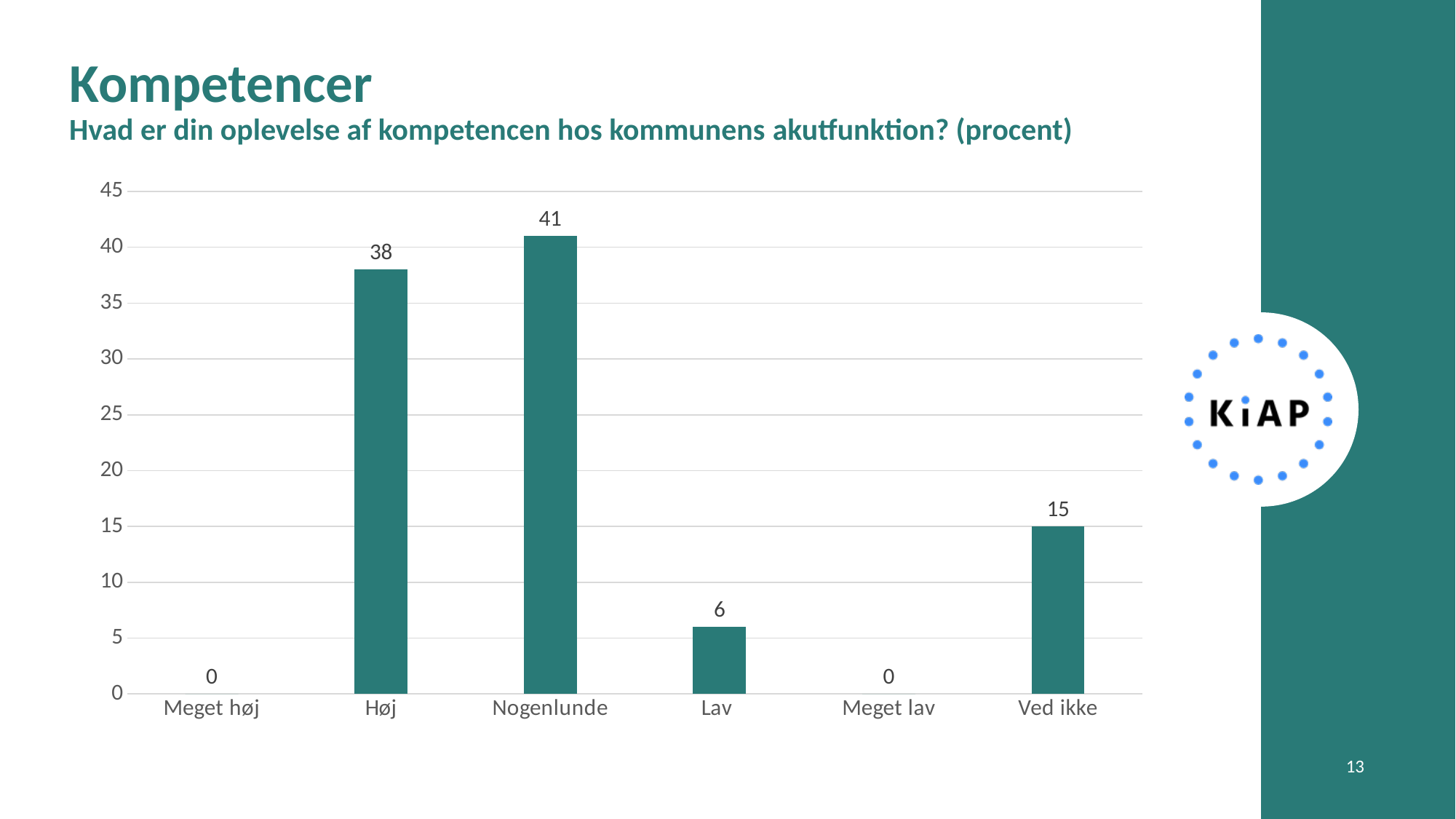
How many categories have a value of 0? 2 Which is larger, the value for Ved ikke or the value for Lav? Ved ikke What kind of chart is shown on the slide? bar chart What is the value for Høj? 38 Is the value for Høj greater or less than 35? greater What is the title of the slide? Kompetencer How many categories are shown on the x axis? 6 What is the value for Ved ikke? 15 What is the value for Nogenlunde? 41 Which category has the highest value? Nogenlunde What is the difference between the values for Nogenlunde and Høj? 3 What is the value for Lav? 6